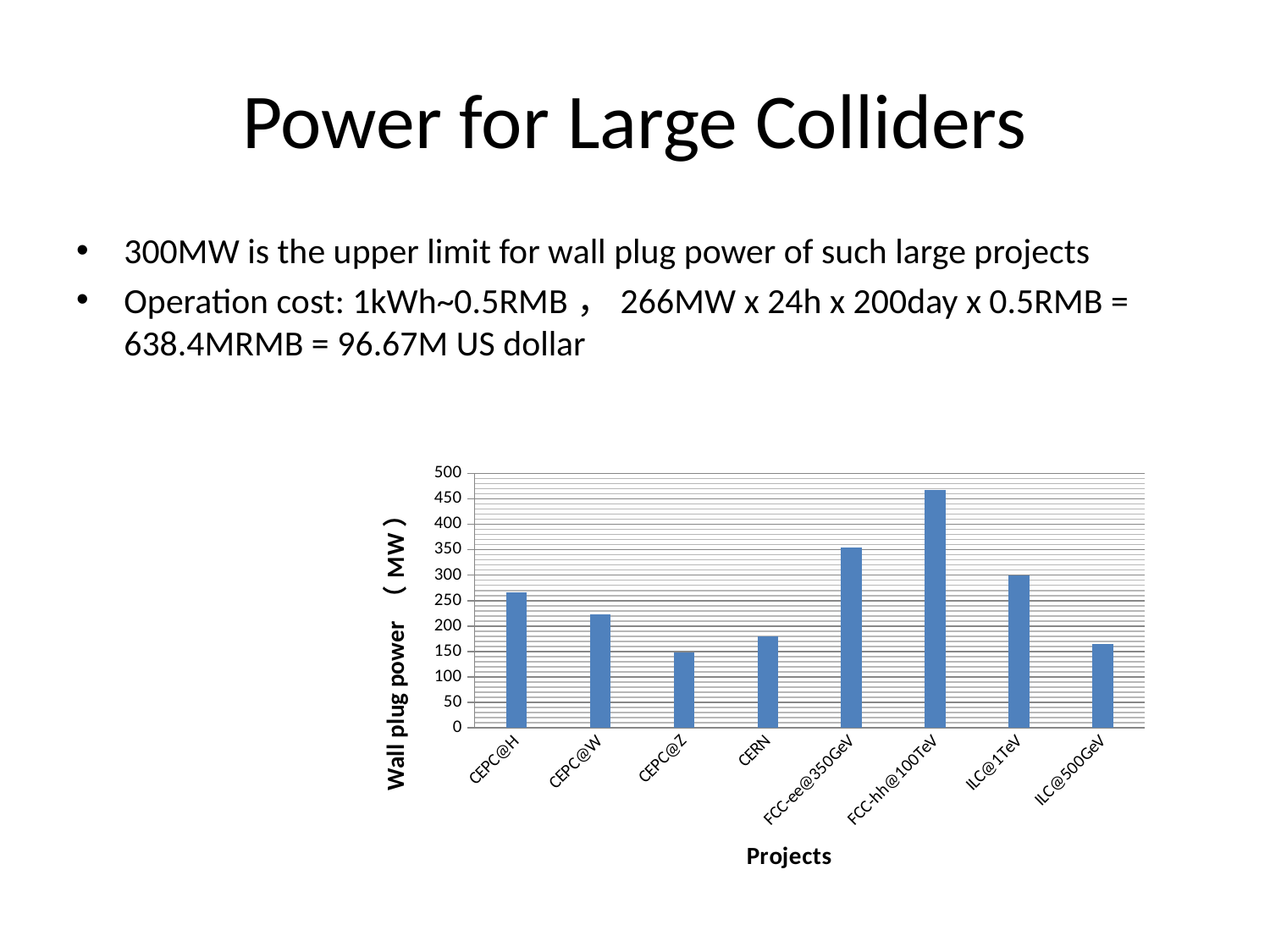
How many projects are plotted on the x axis of the chart? 8 What kind of chart is shown on the slide? bar chart Is the wall plug power for FCC-hh@100TeV greater or less than 450? greater Is the wall plug power for CERN greater or less than 200? less Is the wall plug power for ILC@500GeV greater or less than 200? less Which has the larger wall plug power, FCC-ee@350GeV or ILC@1TeV? FCC-ee@350GeV Which has the larger wall plug power, CEPC@H or CEPC@W? CEPC@H What is the title of the vertical axis of the chart? Wall plug power (MW) Which project has the highest wall plug power in the chart? FCC-hh@100TeV